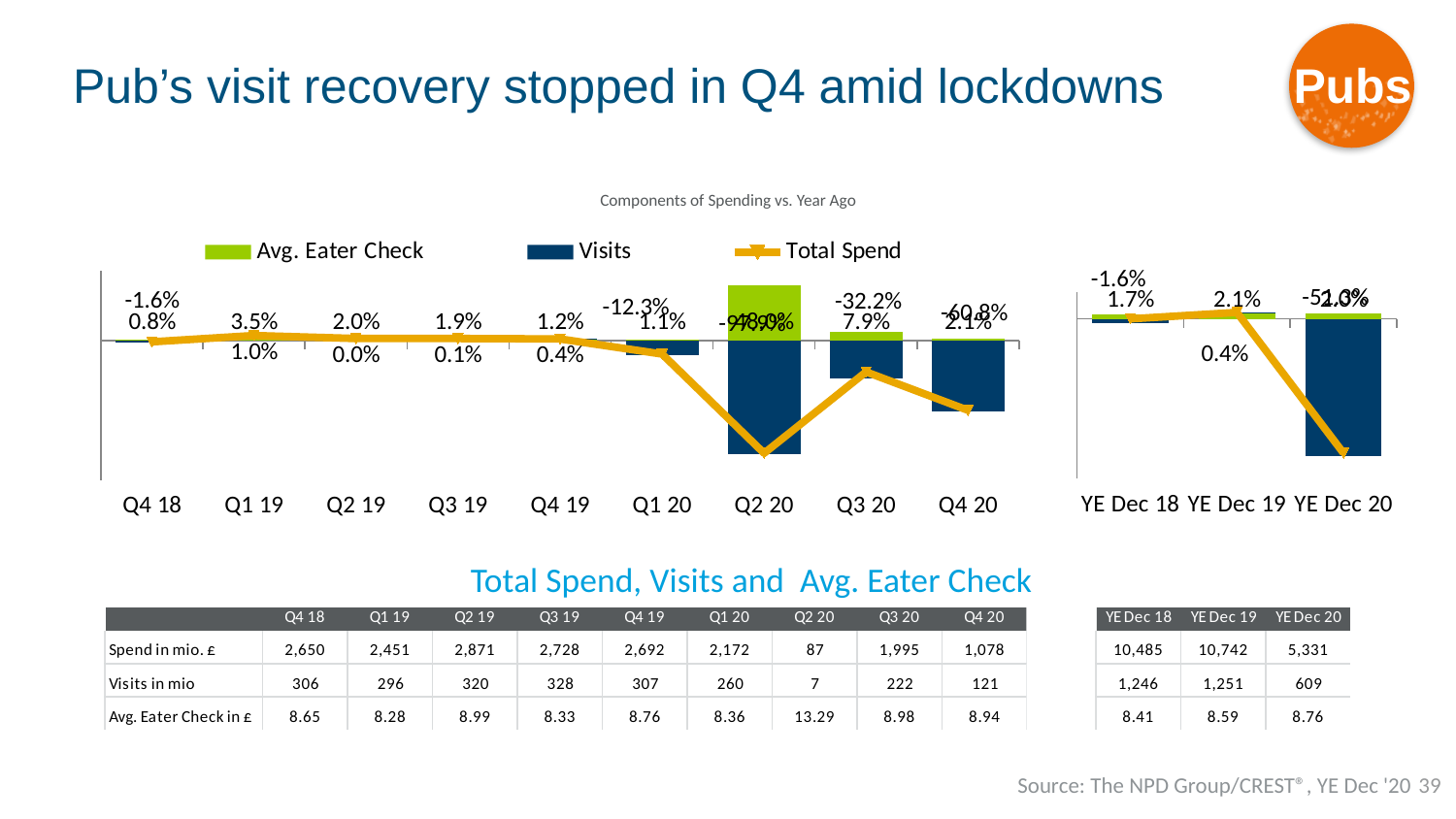
In the table, which quarter has the highest Spend in mio. £? Q2 19 What are the three legend entries on the 'Components of Spending vs. Year Ago' chart? Avg. Eater Check, Visits, Total Spend In the table, what is Spend in mio. £ for Q2 20? 87 In the table, what is the difference in Visits in mio between YE Dec 19 and YE Dec 20? 642 How many series does the legend of the 'Components of Spending vs. Year Ago' chart list? 3 On the left chart, does the Total Spend line rise or fall from Q4 19 to Q2 20? Fall What kind of chart is the left chart titled 'Components of Spending vs. Year Ago'? A combined bar and line chart In the table, which is larger: Avg. Eater Check in £ for Q2 20 or for Q3 20? Q2 20 On the left chart, what percentage change is labelled on the Visits bar for Q3 20? -32.2% In the table, what is Visits in mio for Q4 20? 121 How many periods are shown on the x axis of the right chart (YE Dec)? 3 How many quarters are shown on the x axis of the left chart? 9